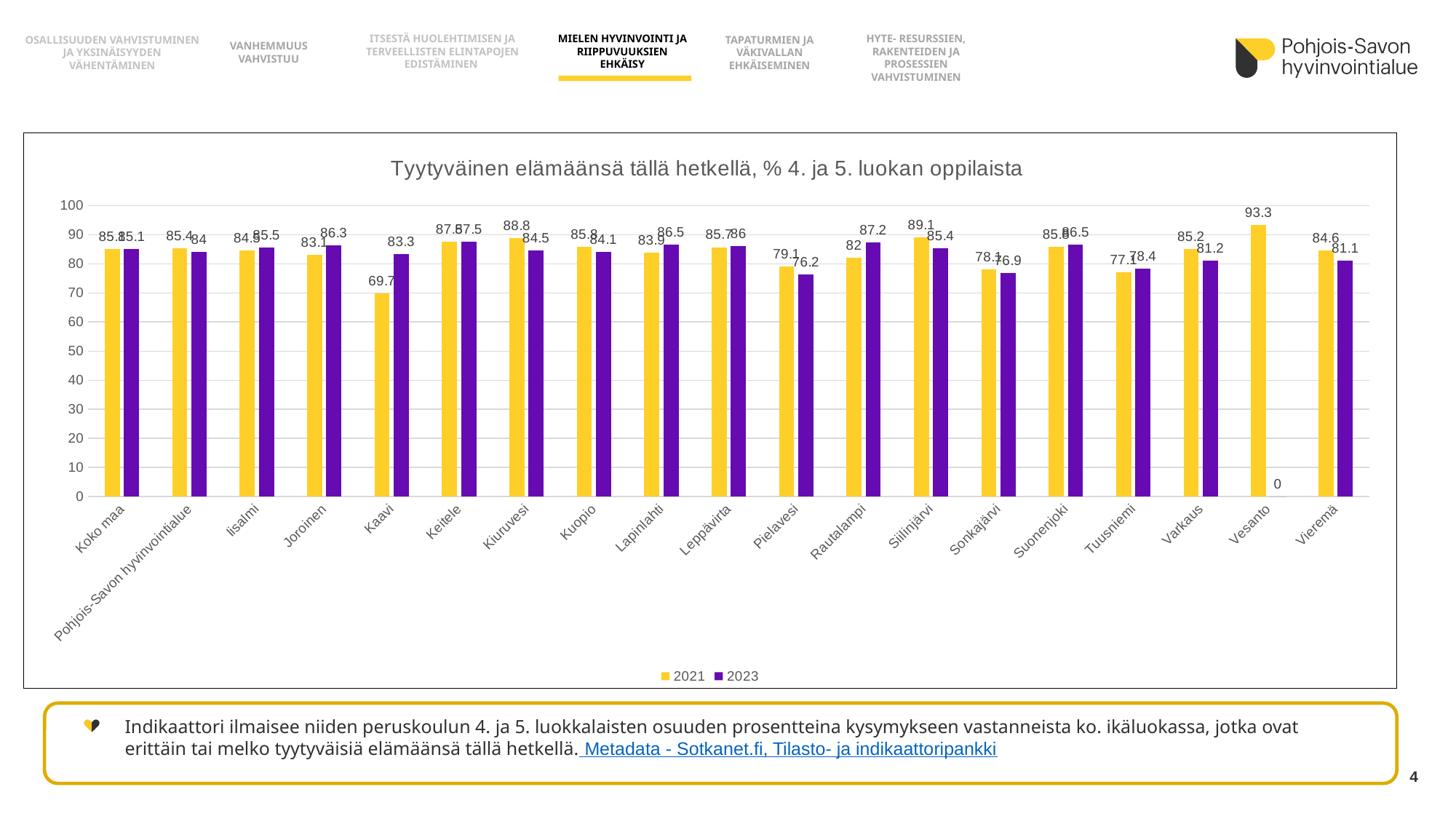
How many series does the legend list? 2 What kind of chart is shown on the slide? bar chart What is the 2021 value for Kaavi? 69.7 What is the 2023 value for Rautalampi? 87.2 What is the difference between the 2023 and 2021 values for Kaavi? 13.6 Is the 2023 value for Pielavesi greater or less than 80? less For Kiuruvesi, which is larger, the 2021 value or the 2023 value? 2021 What is the 2021 value for Vesanto? 93.3 Which category has the highest 2021 value? Vesanto How many categories are shown on the x axis? 19 What is the title of the chart? Tyytyväinen elämäänsä tällä hetkellä, % 4. ja 5. luokan oppilaista Which category has the lowest 2021 value? Kaavi